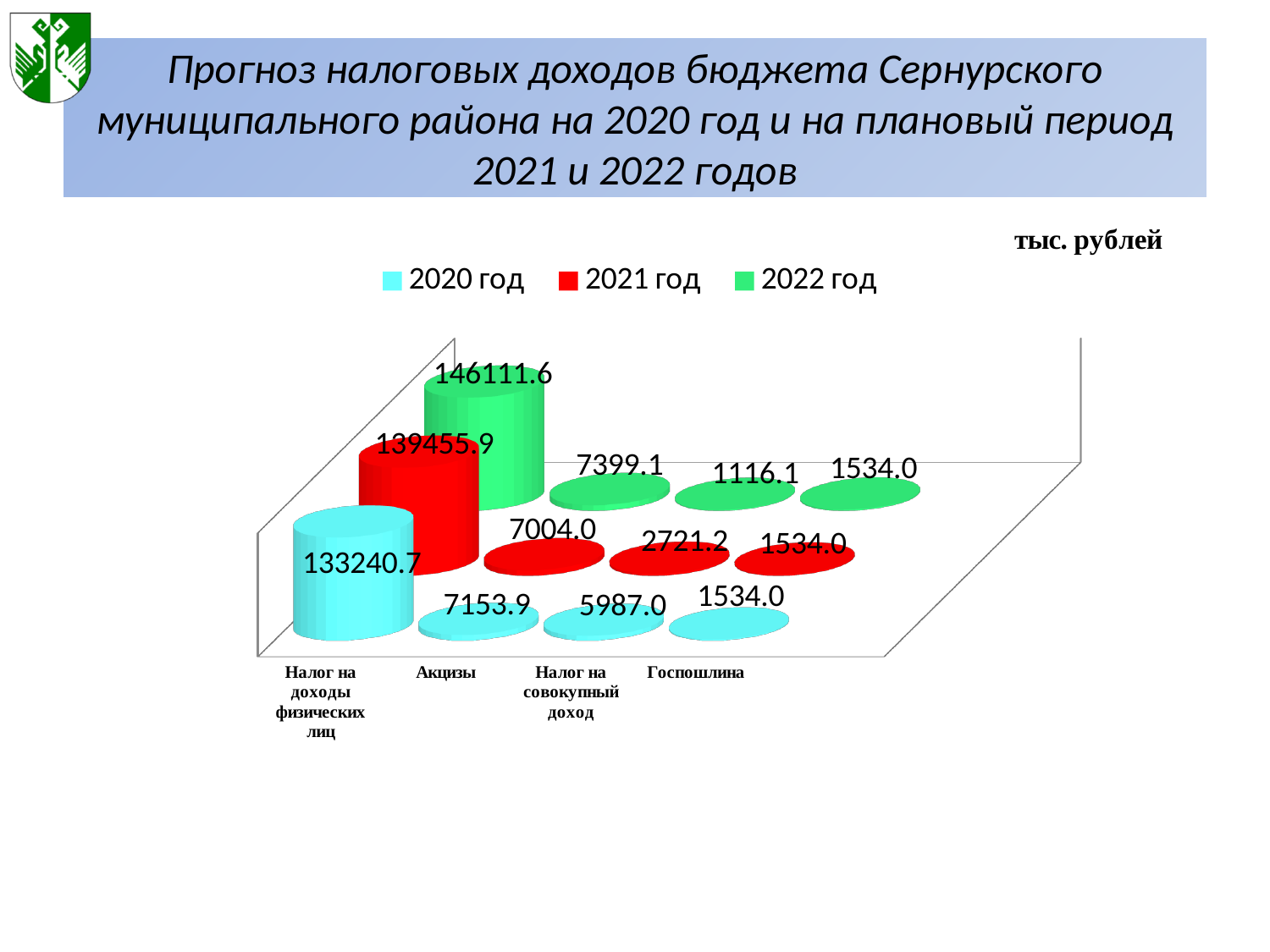
What unit is stated for the values in the chart? тыс. рублей Which category has the highest value in the 2021 год series? Налог на доходы физических лиц Which category has the lowest value in the 2022 год series? Налог на совокупный доход What is the value for Налог на доходы физических лиц in the 2022 год series? 146111.6 How many categories are shown on the x axis? 4 What is the value for Госпошлина in the 2020 год series? 1534.0 What is the value for Налог на доходы физических лиц in the 2020 год series? 133240.7 What is the value for Налог на совокупный доход in the 2022 год series? 1116.1 What is the value for Акцизы in the 2021 год series? 7004.0 What is the difference between the 2022 год and 2020 год values for Налог на доходы физических лиц? 12870.9 How many series does the legend list? 3 Which is larger for Налог на совокупный доход: the 2020 год value or the 2021 год value? 2020 год